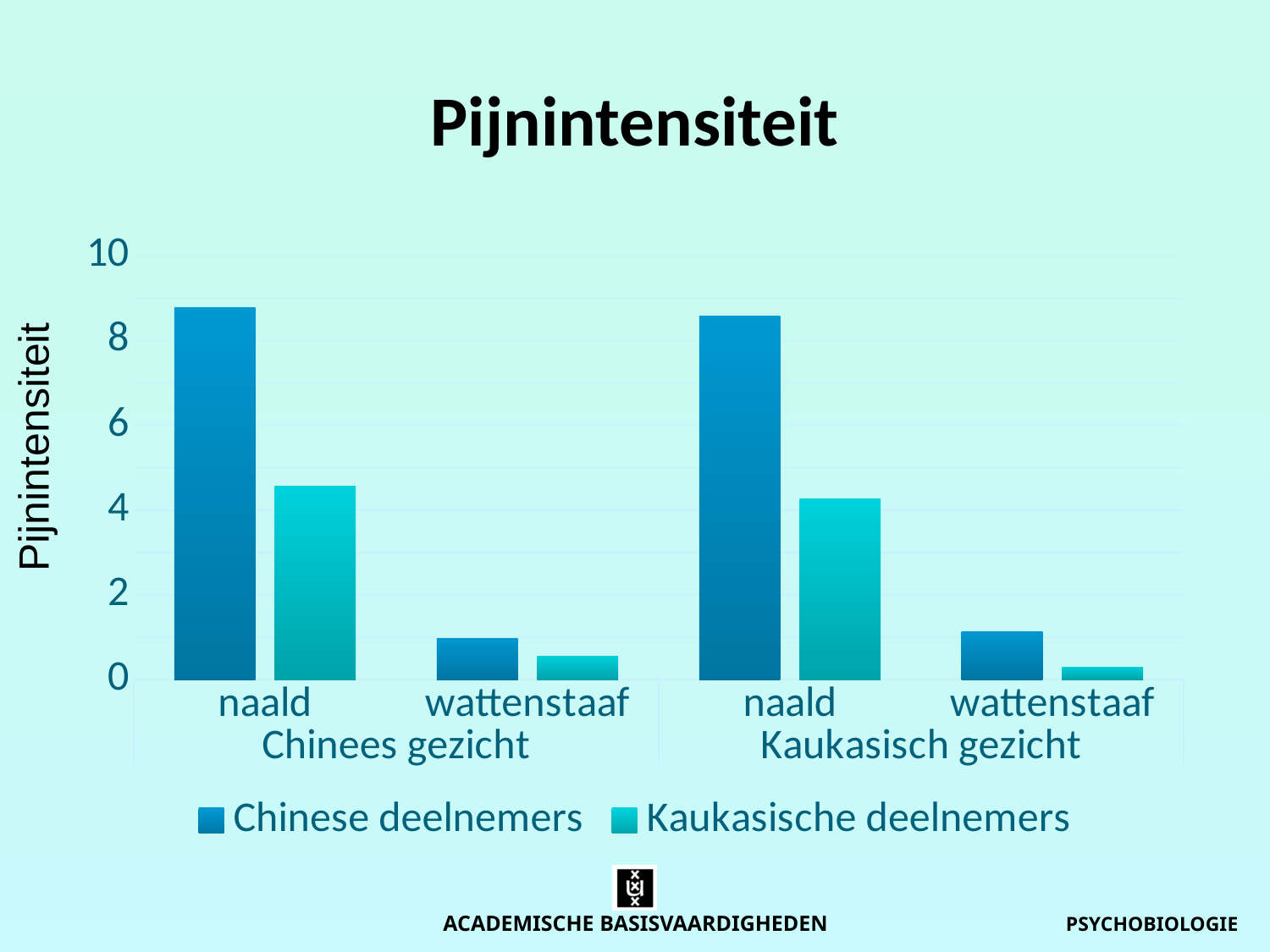
Is the value for Kaukasische deelnemers with naald on the Kaukasisch gezicht greater or less than 2? greater How many category groups (faces) are shown on the x axis? 2 Is the value for Chinese deelnemers with wattenstaaf on the Kaukasisch gezicht greater or less than 2? less For naald on the Kaukasisch gezicht, which series has the larger value: Chinese deelnemers or Kaukasische deelnemers? Chinese deelnemers Is the value for Kaukasische deelnemers with naald on the Chinees gezicht greater or less than 6? less For Chinese deelnemers on the Chinees gezicht, which stimulus has the higher pain intensity: naald or wattenstaaf? naald How many series does the legend list? 2 Do the values for Kaukasische deelnemers fall or rise from naald to wattenstaaf within the Chinees gezicht group? fall What is the title of the chart? Pijnintensiteit Which two series are listed in the legend? Chinese deelnemers and Kaukasische deelnemers What kind of chart is shown on the slide? bar chart